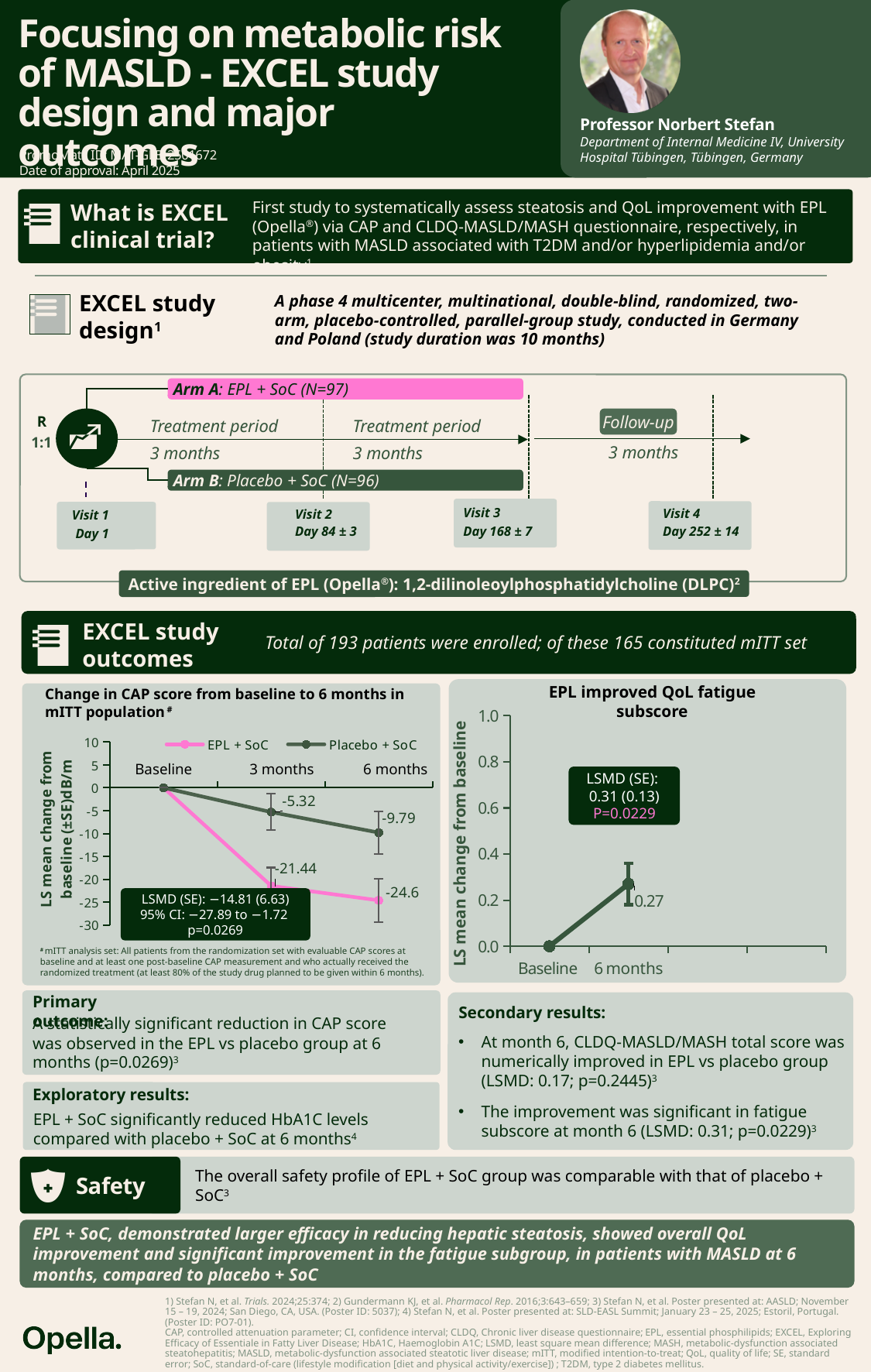
In the 'Change in CAP score from baseline to 6 months in mITT population' chart, which series has the lower value at 3 months, EPL + SoC or Placebo + SoC? EPL + SoC In the 'EPL improved QoL fatigue subscore' chart, what is the value at 6 months? 0.27 What kind of chart is the 'Change in CAP score from baseline to 6 months in mITT population' chart? line chart In the 'Change in CAP score from baseline to 6 months in mITT population' chart, what is the value for EPL + SoC at 3 months? -21.44 In the 'Change in CAP score from baseline to 6 months in mITT population' chart, what is the value for Placebo + SoC at 6 months? -9.79 In the 'Change in CAP score from baseline to 6 months in mITT population' chart, how many series does the legend list? 2 In the 'Change in CAP score from baseline to 6 months in mITT population' chart, what is the difference between the Placebo + SoC and EPL + SoC values at 6 months? 14.81 In the 'Change in CAP score from baseline to 6 months in mITT population' chart, what is the value for EPL + SoC at 6 months? -24.6 In the 'Change in CAP score from baseline to 6 months in mITT population' chart, do the values for EPL + SoC rise or fall from Baseline to 6 months? fall In the 'EPL improved QoL fatigue subscore' chart, is the value at 6 months greater or less than 0.4? less In the 'EPL improved QoL fatigue subscore' chart, how many time points are plotted on the x axis? 2 In the 'Change in CAP score from baseline to 6 months in mITT population' chart, what is the value for Placebo + SoC at 3 months? -5.32